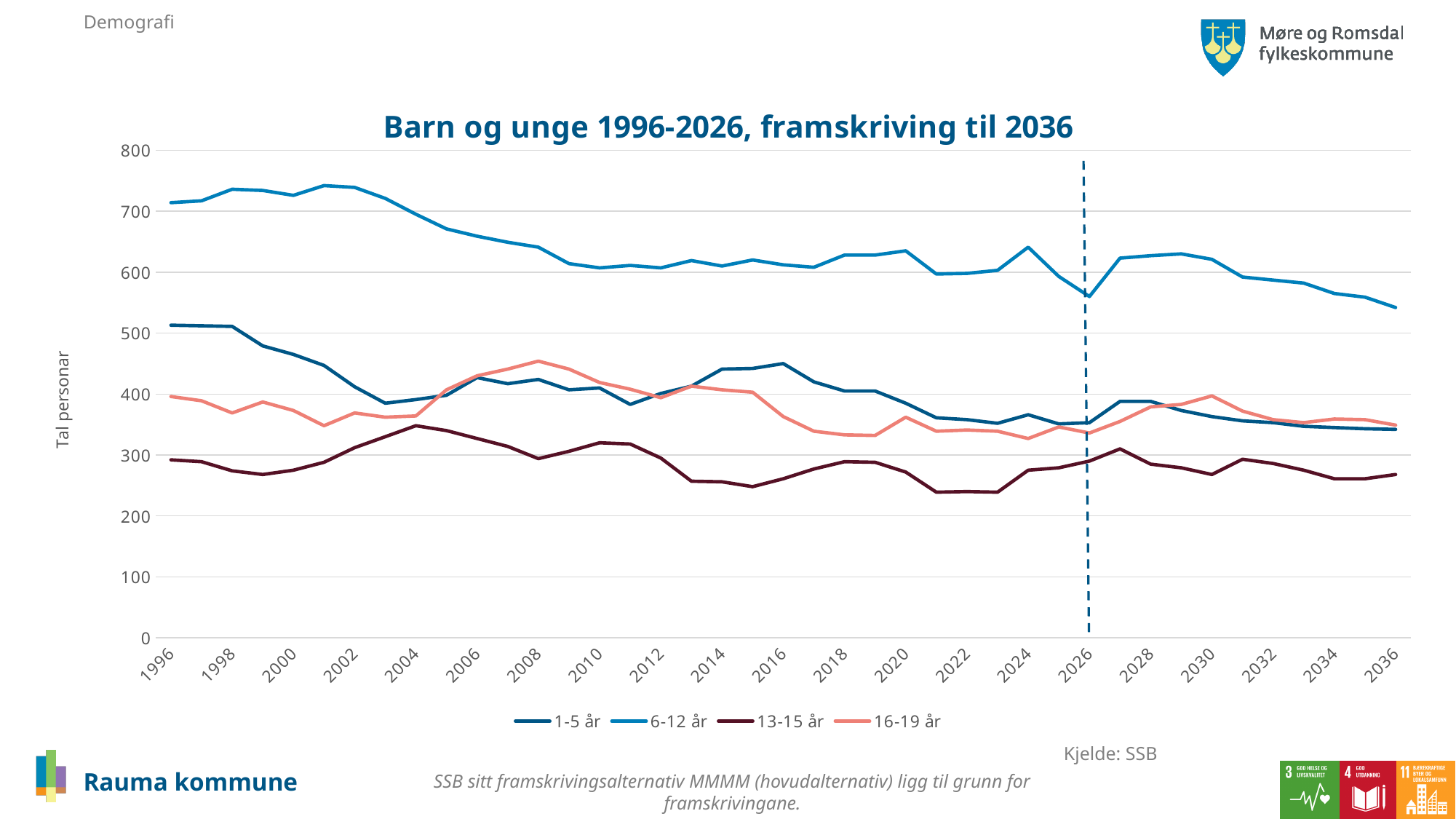
What is the title of the chart? Barn og unge 1996-2026, framskriving til 2036 Is the value for 6-12 år in 2036 greater or less than 600? less Which series has the highest values across the whole period? 6-12 år In 2010, which is larger: the value for 6-12 år or the value for 13-15 år? 6-12 år Is the value for 13-15 år in 2022 greater or less than 300? less How many series does the legend list? 4 Is the value for 1-5 år in 1996 greater or less than 500? greater What is the label on the vertical axis? Tal personar What kind of chart is shown on the slide? line chart Does the 6-12 år series rise or fall overall from 1996 to 2036? fall Which series has the lowest values across the whole period? 13-15 år